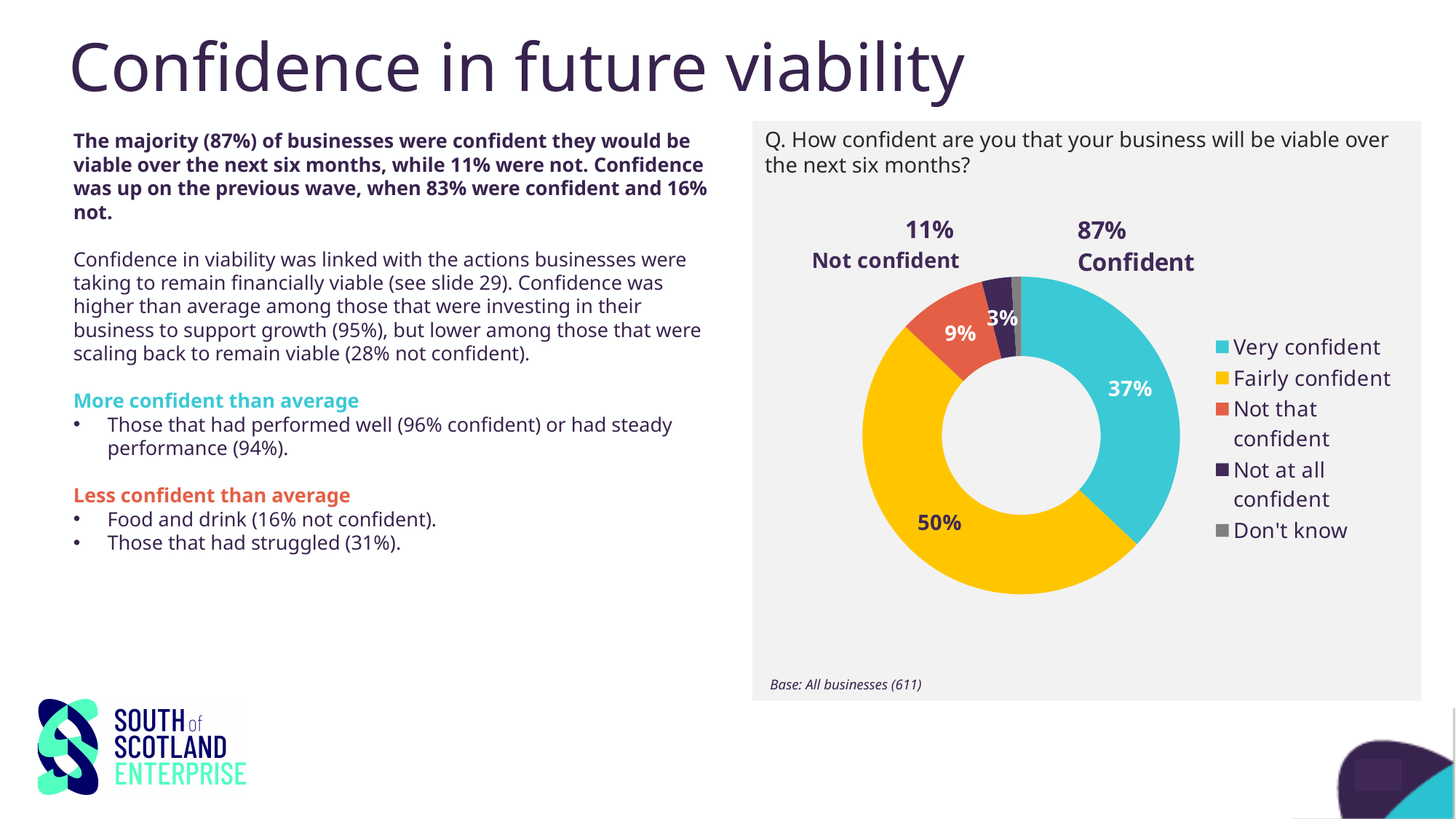
What percentage of businesses were very confident? 37% What is the difference in percentage points between fairly confident and very confident? 13 Which response category has the largest share of the donut chart? Fairly confident What combined percentage is labelled as 'Confident' on the chart? 87% Which is larger: the share for very confident or the share for not that confident? Very confident Which labelled response category has the smallest share of the donut chart? Not at all confident What percentage of businesses were fairly confident their business will be viable over the next six months? 50% How many categories does the chart legend list? 5 What type of chart is shown on the slide? Donut (pie) chart What percentage of businesses were not that confident? 9% What is the base (number of businesses) stated beneath the chart? All businesses (611) What percentage of businesses were not at all confident? 3%